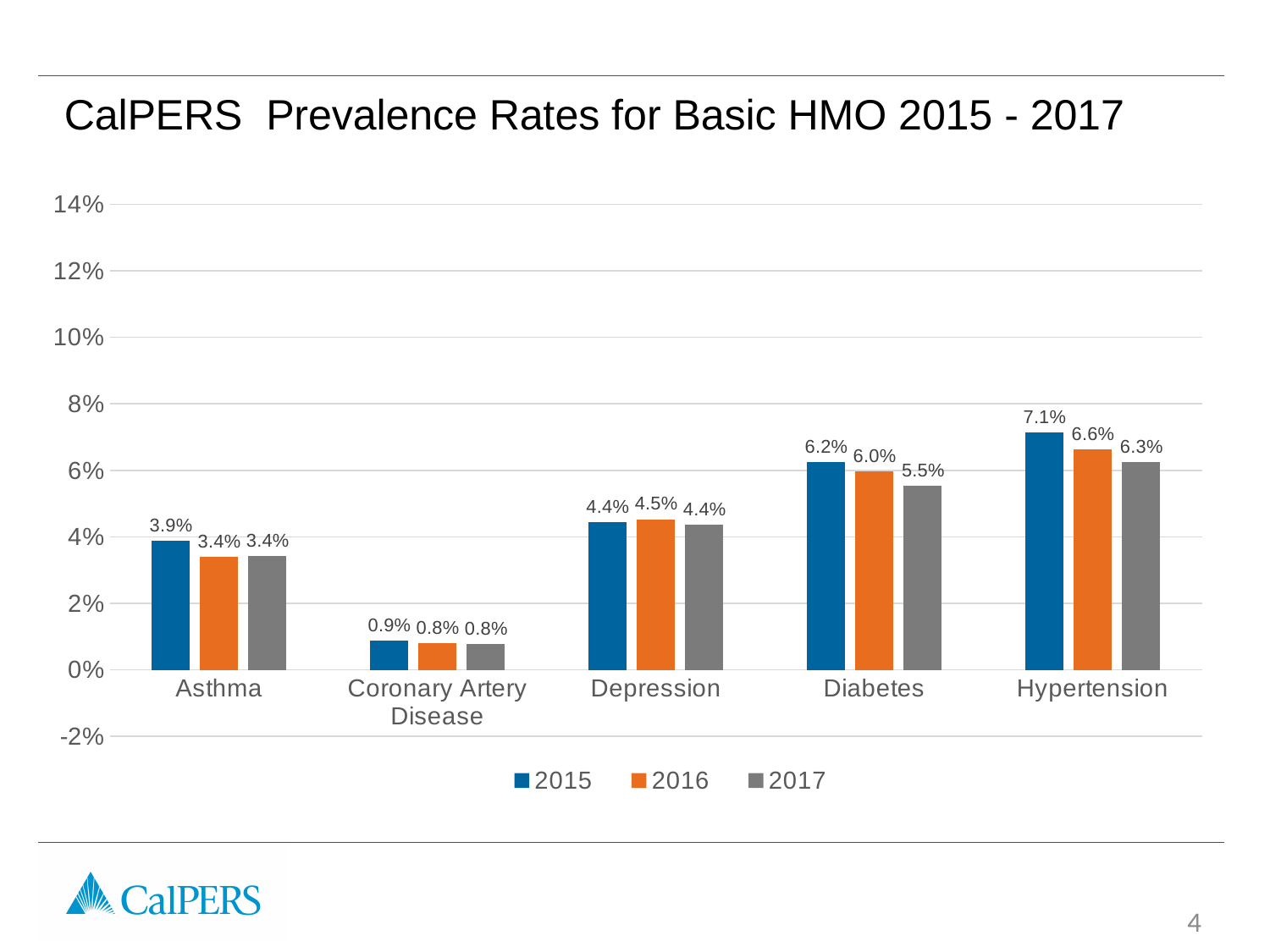
How many series does the legend list? 3 Did the prevalence rate for Hypertension rise or fall from 2015 to 2017? Fall What is the prevalence rate for Coronary Artery Disease in 2017? 0.8% What is the difference between the Hypertension prevalence rates in 2015 and 2017? 0.8% Is the value for Diabetes in 2017 greater or less than 4%? greater Which condition has the highest prevalence rate in 2015? Hypertension Which condition has the lowest prevalence rate in 2017? Coronary Artery Disease What kind of chart is shown on the slide? Bar chart How many conditions are shown on the x axis? 5 What is the prevalence rate for Diabetes in 2015? 6.2% Which is larger, the Asthma rate in 2015 or the Asthma rate in 2016? 2015 What is the prevalence rate for Depression in 2016? 4.5%